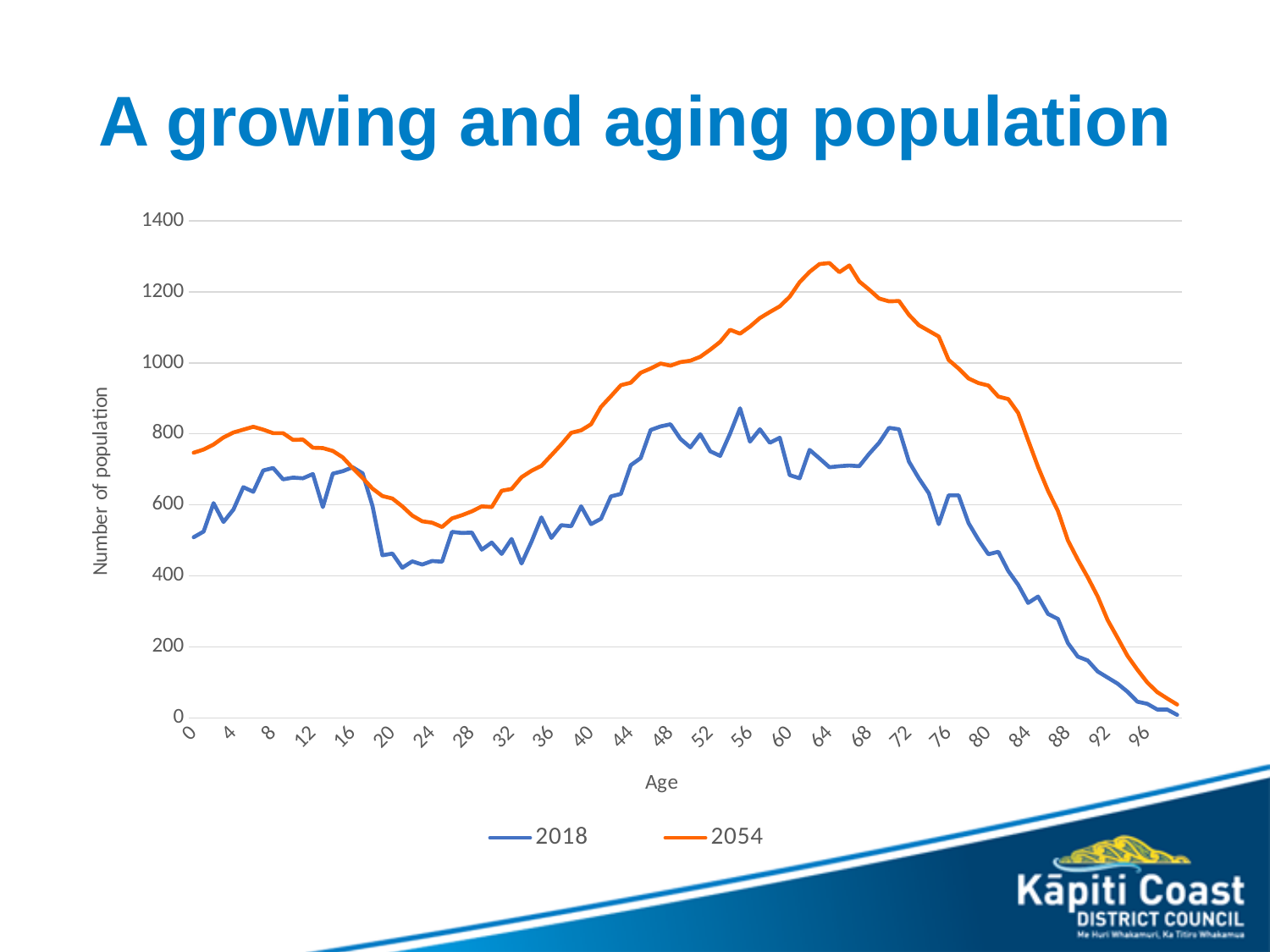
At age 8, which series has the higher value, 2018 or 2054? 2054 What is the label on the vertical axis? Number of population At age 64, which series has the higher value, 2018 or 2054? 2054 What kind of chart is shown on the slide? line chart Is the value for 2054 at age 24 greater or less than 800? less How many series does the legend list? 2 Is the value for 2054 at age 64 greater or less than 1200? greater Is the value for 2018 at age 96 greater or less than 200? less Does the 2054 line rise or fall between age 64 and age 96? fall What are the two series named in the legend? 2018 and 2054